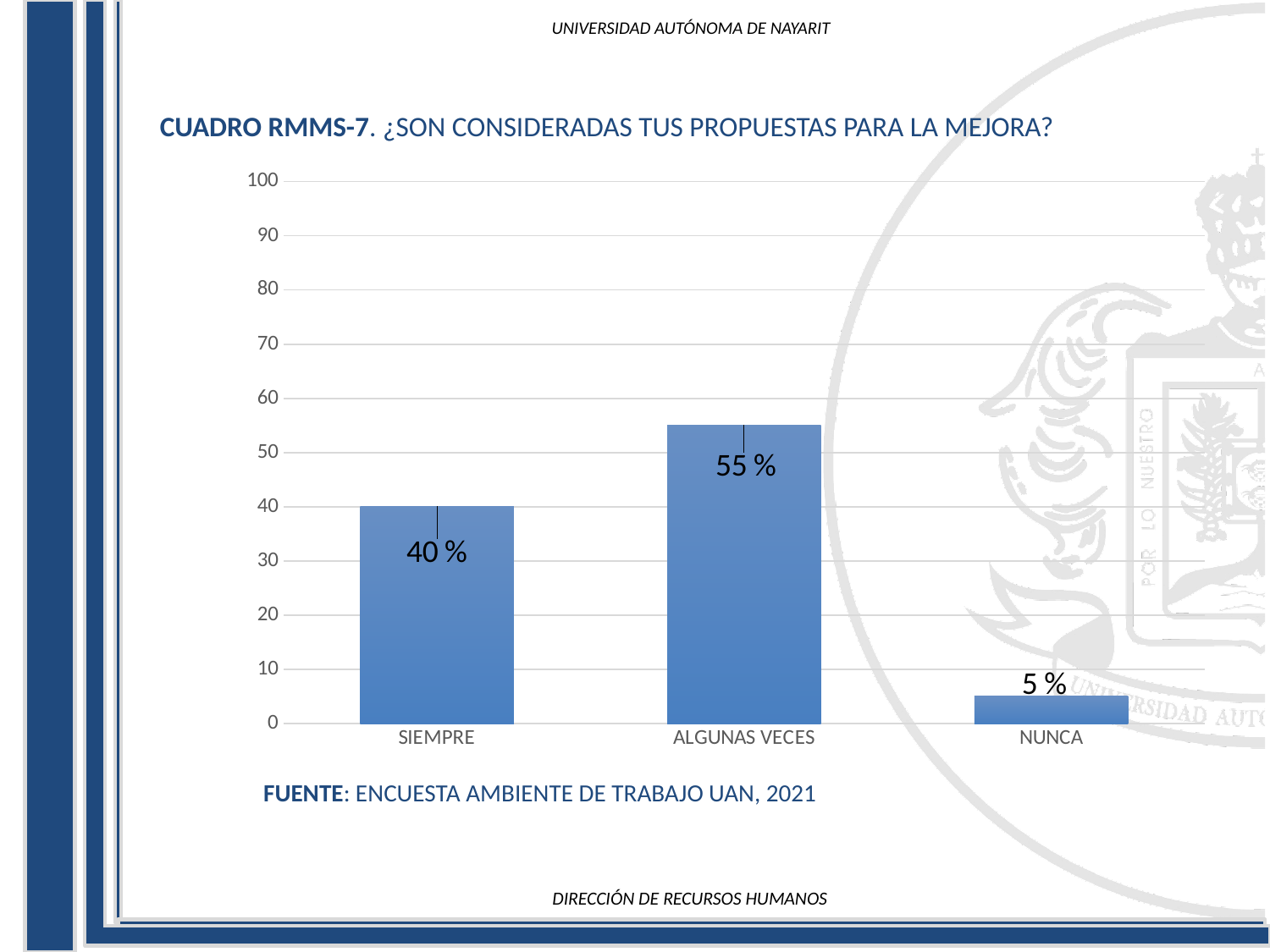
What is the source cited below the chart? ENCUESTA AMBIENTE DE TRABAJO UAN, 2021 What is the value for ALGUNAS VECES? 55 % What is the value for SIEMPRE? 40 % What is the difference between the values for SIEMPRE and NUNCA? 35 % What kind of chart is shown on the slide? bar chart Which category has the highest value? ALGUNAS VECES How many categories are shown on the x axis? 3 What is the difference between the values for ALGUNAS VECES and SIEMPRE? 15 % Is the value for ALGUNAS VECES greater or less than 50? greater Which category has the lowest value? NUNCA What is the value for NUNCA? 5 % Which is larger, the value for SIEMPRE or the value for NUNCA? SIEMPRE